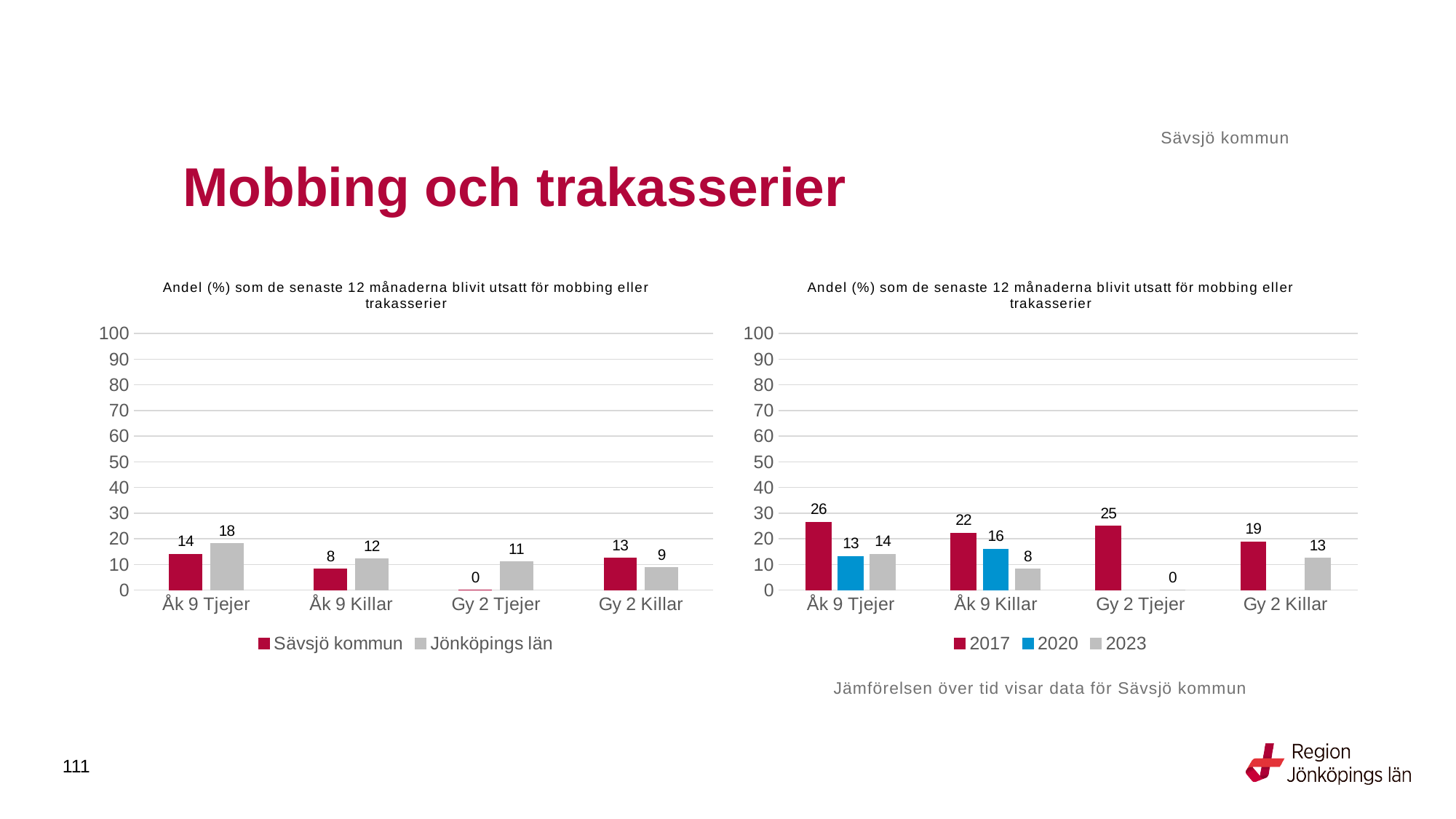
In the left chart, which category has the lowest value for Sävsjö kommun? Gy 2 Tjejer In the right chart, which category has the highest value for 2017? Åk 9 Tjejer How many series does the legend of the right chart list? 3 In the left chart, what is the value for Jönköpings län for Gy 2 Tjejer? 11 In the left chart, which category has the highest value for Jönköpings län? Åk 9 Tjejer In the left chart, which is larger for Gy 2 Killar: Sävsjö kommun or Jönköpings län? Sävsjö kommun In the left chart, what is the value for Sävsjö kommun for Åk 9 Tjejer? 14 In the right chart, what is the difference between 2017 and 2023 for Åk 9 Killar? 14 In the right chart, what is the value for 2017 for Åk 9 Tjejer? 26 What kind of chart is the left chart? Bar chart In the right chart, what is the value for 2023 for Gy 2 Killar? 13 In the left chart, what is the difference between Jönköpings län and Sävsjö kommun for Åk 9 Killar? 4